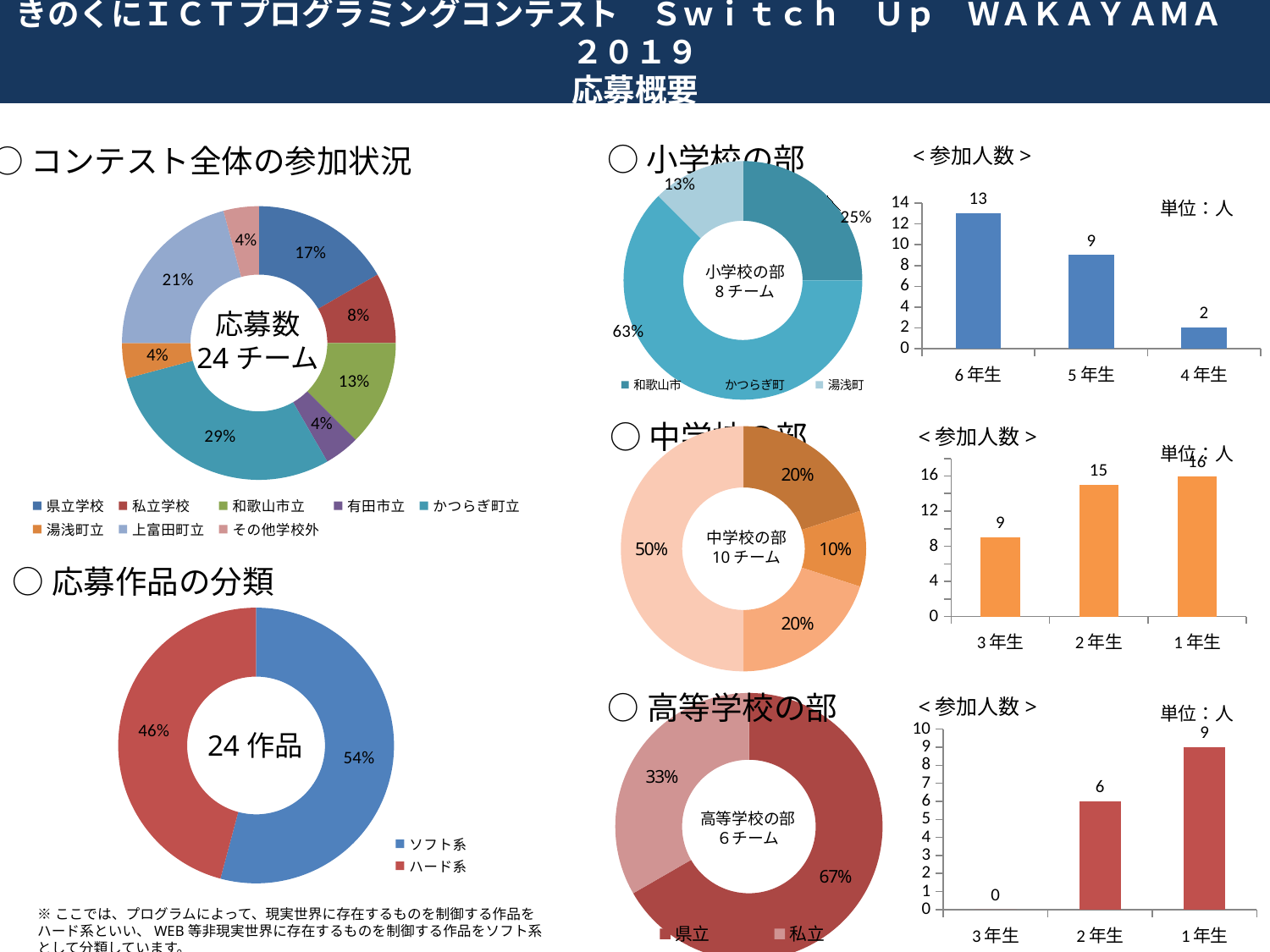
In the 高等学校の部 参加人数 bar chart, what is the value for 3年生? 0 In the 小学校の部 donut chart, what share is かつらぎ町? 63% In the 小学校の部 参加人数 bar chart, what is the difference between 6年生 and 5年生? 4 In the 小学校の部 参加人数 bar chart, what is the value for 6年生? 13 In the 中学校の部 参加人数 bar chart, what is the value for 2年生? 15 In the 小学校の部 参加人数 bar chart, which grade has the lowest value? 4年生 In the 高等学校の部 参加人数 bar chart, do the values rise or fall from 3年生 to 1年生 along the x axis? rise In the コンテスト全体の参加状況 donut chart, what share is かつらぎ町立? 29% In the 中学校の部 参加人数 bar chart, which grade has the highest value? 1年生 How many entries does the legend of the コンテスト全体の参加状況 donut chart list? 8 In the 応募作品の分類 donut chart, what share is ソフト系? 54% In the 高等学校の部 参加人数 bar chart, which is larger, 2年生 or 1年生? 1年生